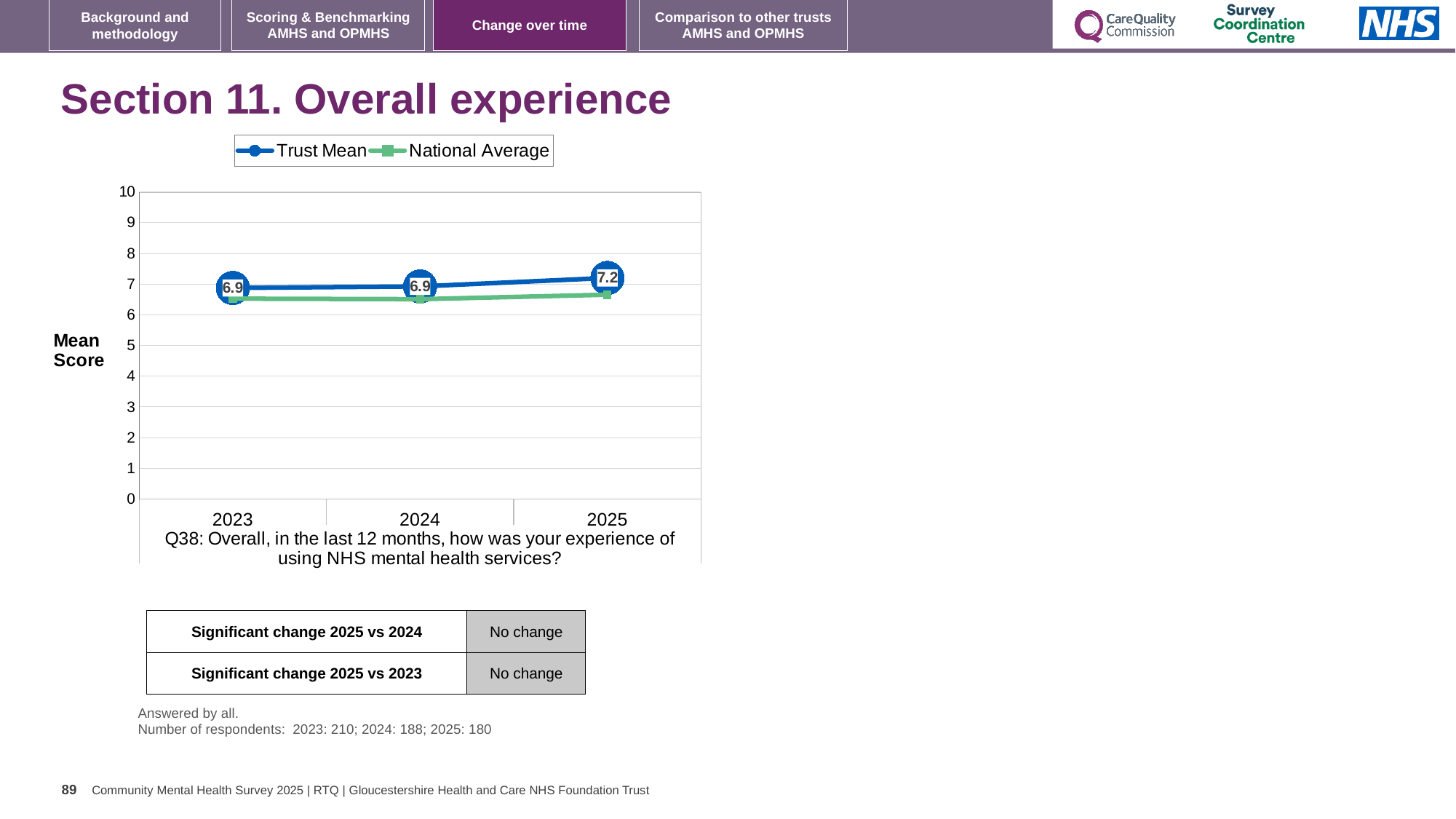
What is the Trust Mean score for 2025? 7.2 What is the difference between the Trust Mean in 2025 and in 2024? 0.3 How many years are plotted on the x axis? 3 In which year is the Trust Mean highest? 2025 Is the Trust Mean for 2025 greater or less than the National Average for 2025? greater What is the Trust Mean score for 2023? 6.9 What is the Trust Mean score for 2024? 6.9 Is the National Average for 2025 greater or less than 6? greater How many series does the legend list? 2 Does the Trust Mean rise or fall from 2024 to 2025? rise What kind of chart is shown on the slide? line chart Is the National Average for 2023 greater or less than 7? less